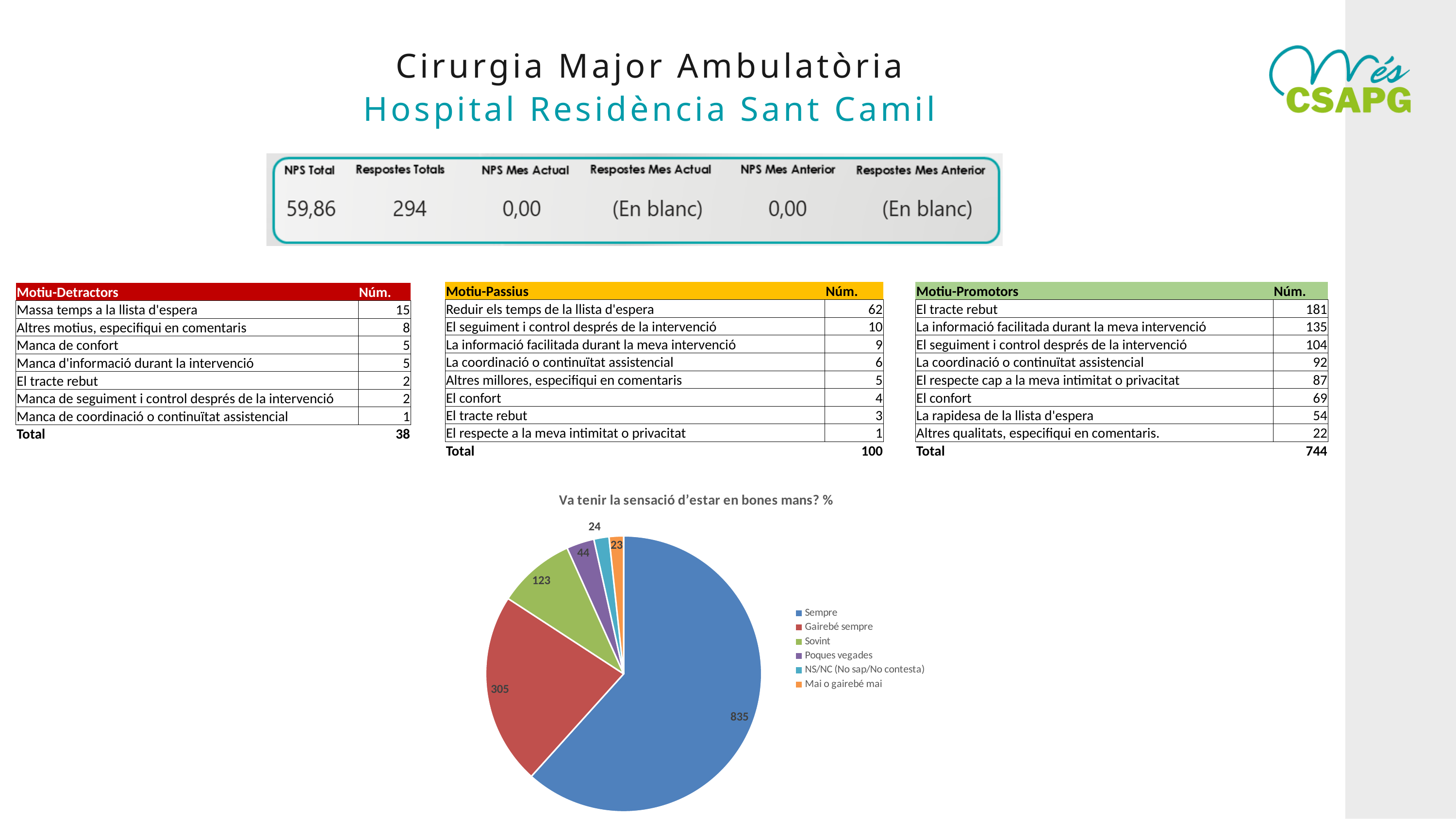
What is the title of the pie chart? Va tenir la sensació d'estar en bones mans? % What is the difference between the 'Sempre' and 'Gairebé sempre' values in the pie chart? 530 What is the value for the 'Gairebé sempre' slice in the pie chart? 305 What colour is the 'Sempre' slice in the pie chart? blue Which is larger in the pie chart, 'Sovint' or 'Poques vegades'? Sovint What kind of chart is shown on the slide? pie chart How many slices does the pie chart have? 6 What is the value for the 'Poques vegades' slice in the pie chart? 44 What is the value for the 'Sempre' slice in the pie chart? 835 What is the value for the 'NS/NC (No sap/No contesta)' slice in the pie chart? 24 Which category has the largest slice in the pie chart? Sempre What is the value for the 'Sovint' slice in the pie chart? 123